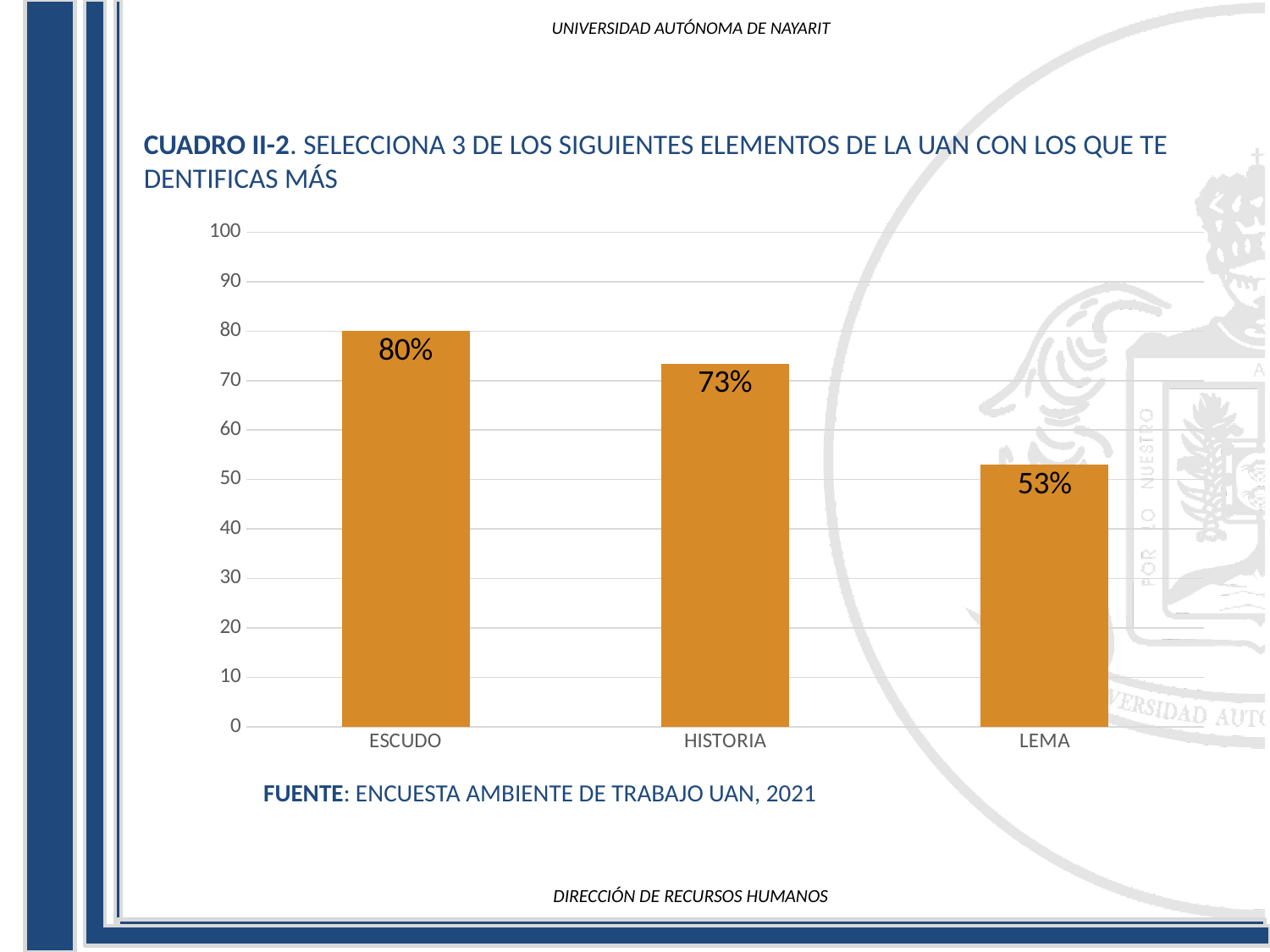
How many categories are shown in the chart? 3 What is the value for ESCUDO? 80% What is the difference between the values for HISTORIA and LEMA? 20% What is the value for LEMA? 53% Which category has the lowest value? LEMA What is the difference between the values for ESCUDO and LEMA? 27% What kind of chart is shown on the slide? bar chart Which category has the highest value? ESCUDO Is the value for LEMA greater or less than 60? less What is the value for HISTORIA? 73% Do the values rise or fall from ESCUDO to LEMA along the x axis? fall Which is larger, the value for HISTORIA or the value for LEMA? HISTORIA